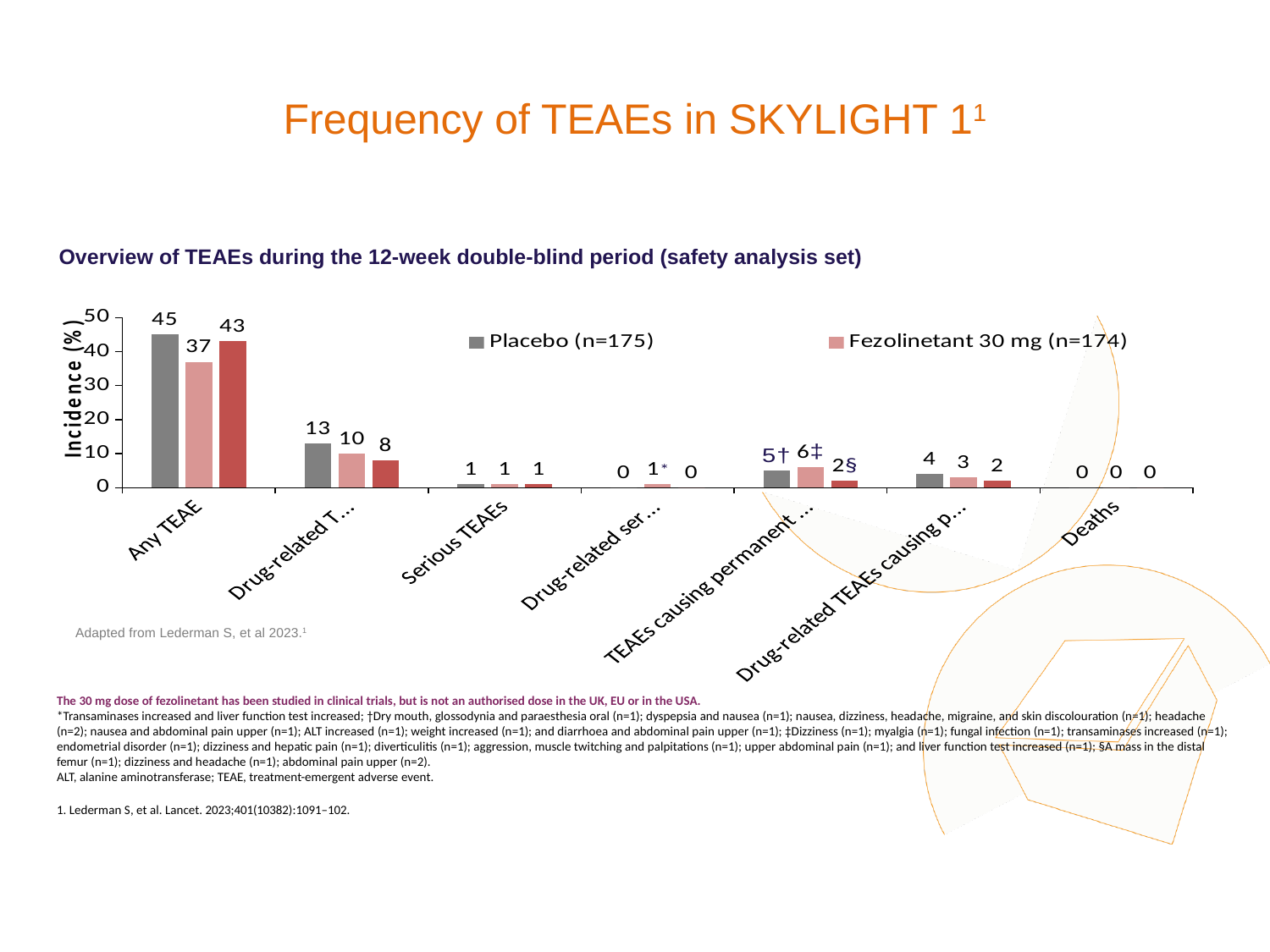
What is the label of the y axis of the chart? Incidence (%) What sample size is given for the Placebo group in the legend? n=175 Is the Placebo incidence for Any TEAE greater or less than 40? greater What is the incidence of Deaths for the Fezolinetant 30 mg group? 0 What is the incidence of Any TEAE for the Placebo (n=175) group? 45 What is the difference between the Placebo and Fezolinetant 30 mg incidence for Any TEAE? 8 What is the incidence of Serious TEAEs for the Placebo group? 1 What kind of chart is shown on the slide? Bar chart How many categories are shown on the x axis of the chart? 7 For Any TEAE, which group has the higher incidence: Placebo or Fezolinetant 30 mg? Placebo What is the incidence of Any TEAE for the Fezolinetant 30 mg (n=174) group? 37 Which category has the highest incidence for the Placebo group? Any TEAE